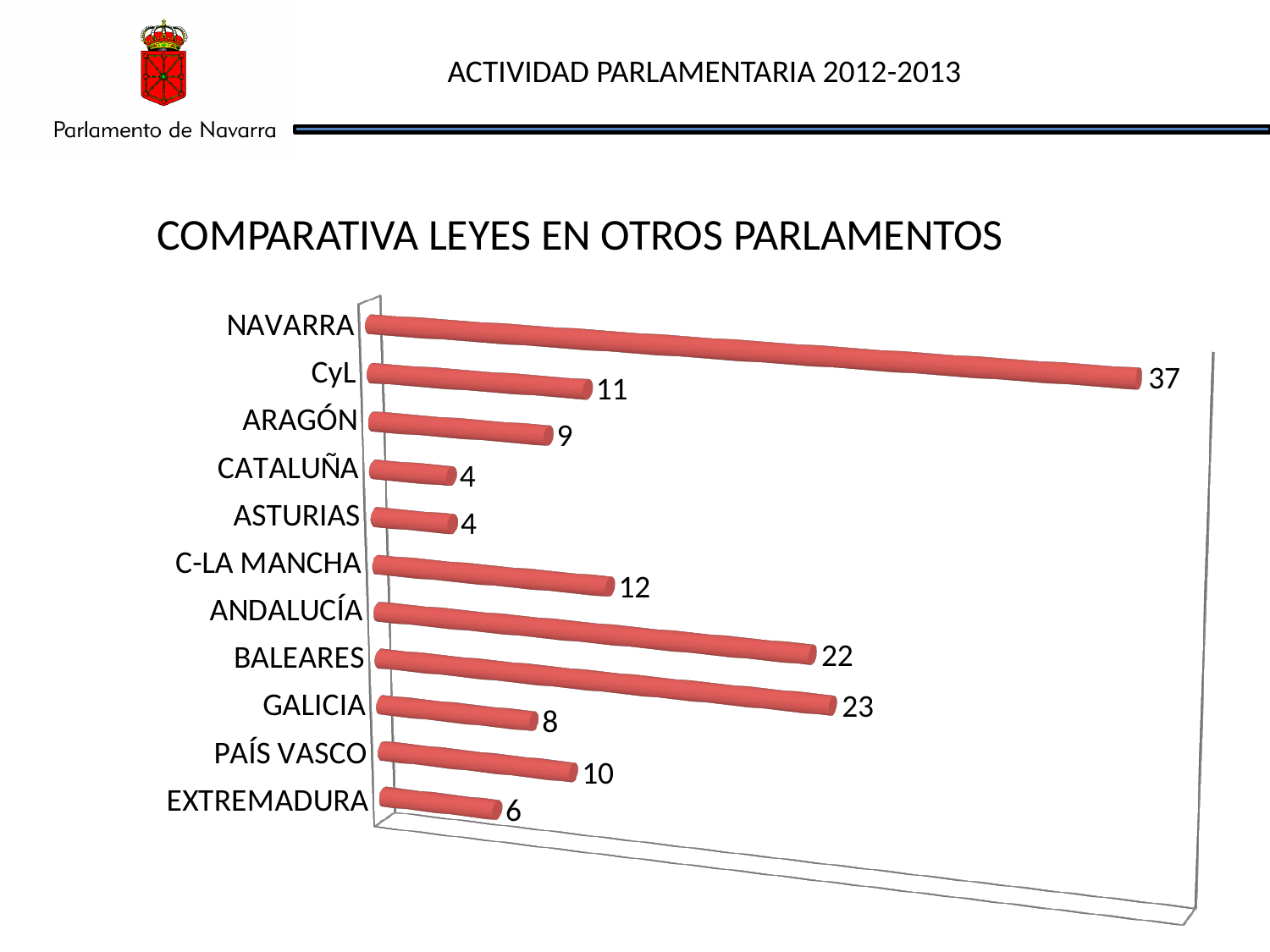
What is the title of the chart? COMPARATIVA LEYES EN OTROS PARLAMENTOS What is the value for NAVARRA? 37 What is the value for C-LA MANCHA? 12 What kind of chart is shown on the slide? Bar chart What is the difference between the values for NAVARRA and BALEARES? 14 How many categories are shown in the chart? 11 What is the difference between the values for CyL and ARAGÓN? 2 What is the value for BALEARES? 23 What is the value for PAÍS VASCO? 10 Which category has the highest value? NAVARRA What is the value for EXTREMADURA? 6 Which is larger, the value for ANDALUCÍA or the value for GALICIA? ANDALUCÍA